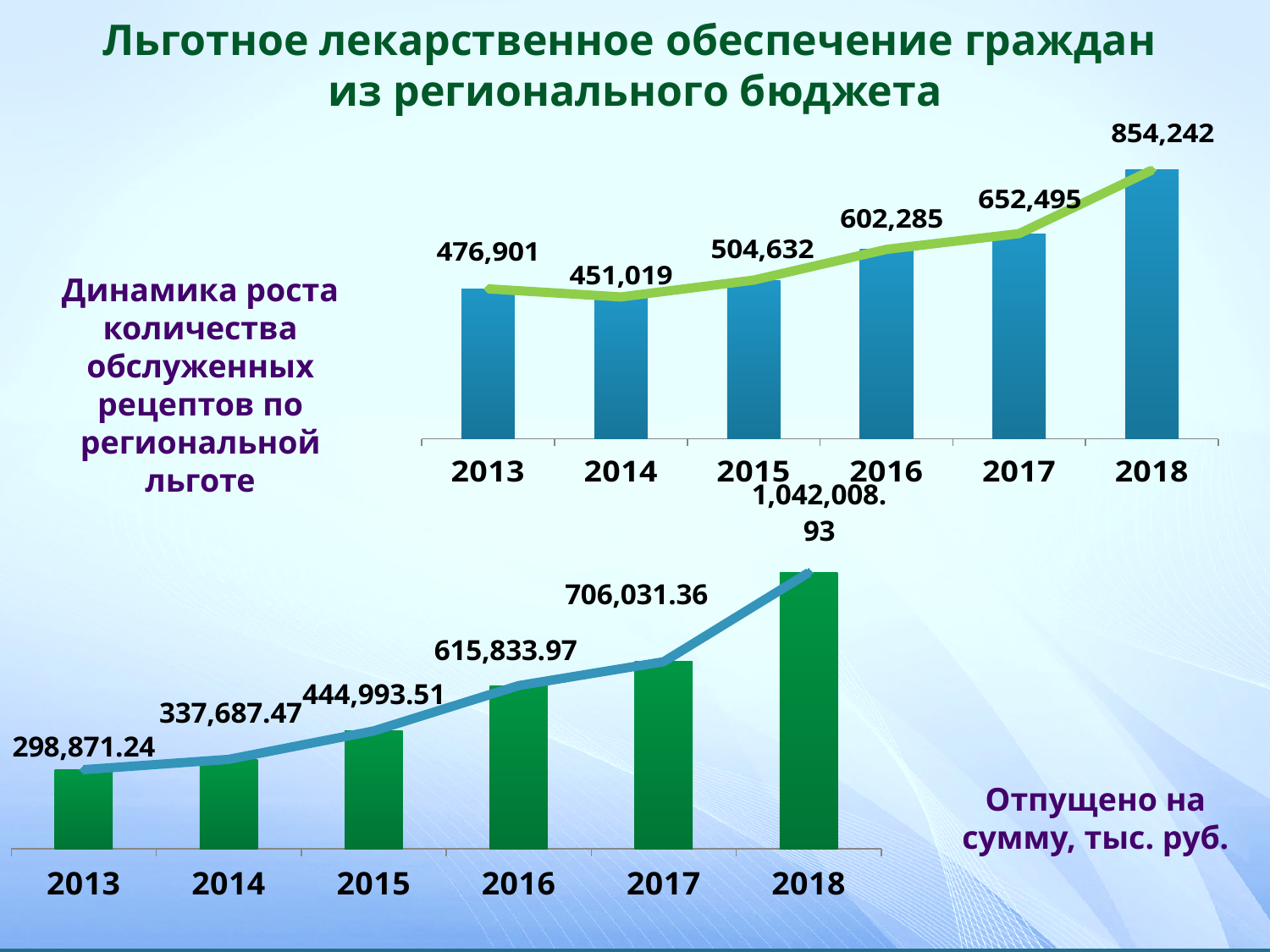
How many years are shown on the x axis of the top chart? 6 In the bottom chart, what is the value for 2018? 1,042,008.93 In the top chart, what is the difference between the values for 2018 and 2017? 201,747 In the top chart (Динамика роста количества обслуженных рецептов по региональной льготе), what is the value for 2016? 602,285 In the top chart, which is larger: the value for 2013 or the value for 2014? 2013 In the bottom chart, what is the difference between the values for 2017 and 2016? 90,197.39 In the bottom chart, which year has the lowest value? 2013 In the top chart, what is the value for 2014? 451,019 In the top chart, which year has the highest value? 2018 In the top chart, which year has the lowest value? 2014 In the bottom chart, do the values rise or fall from 2013 to 2018? rise In the bottom chart (Отпущено на сумму, тыс. руб.), what is the value for 2015? 444,993.51